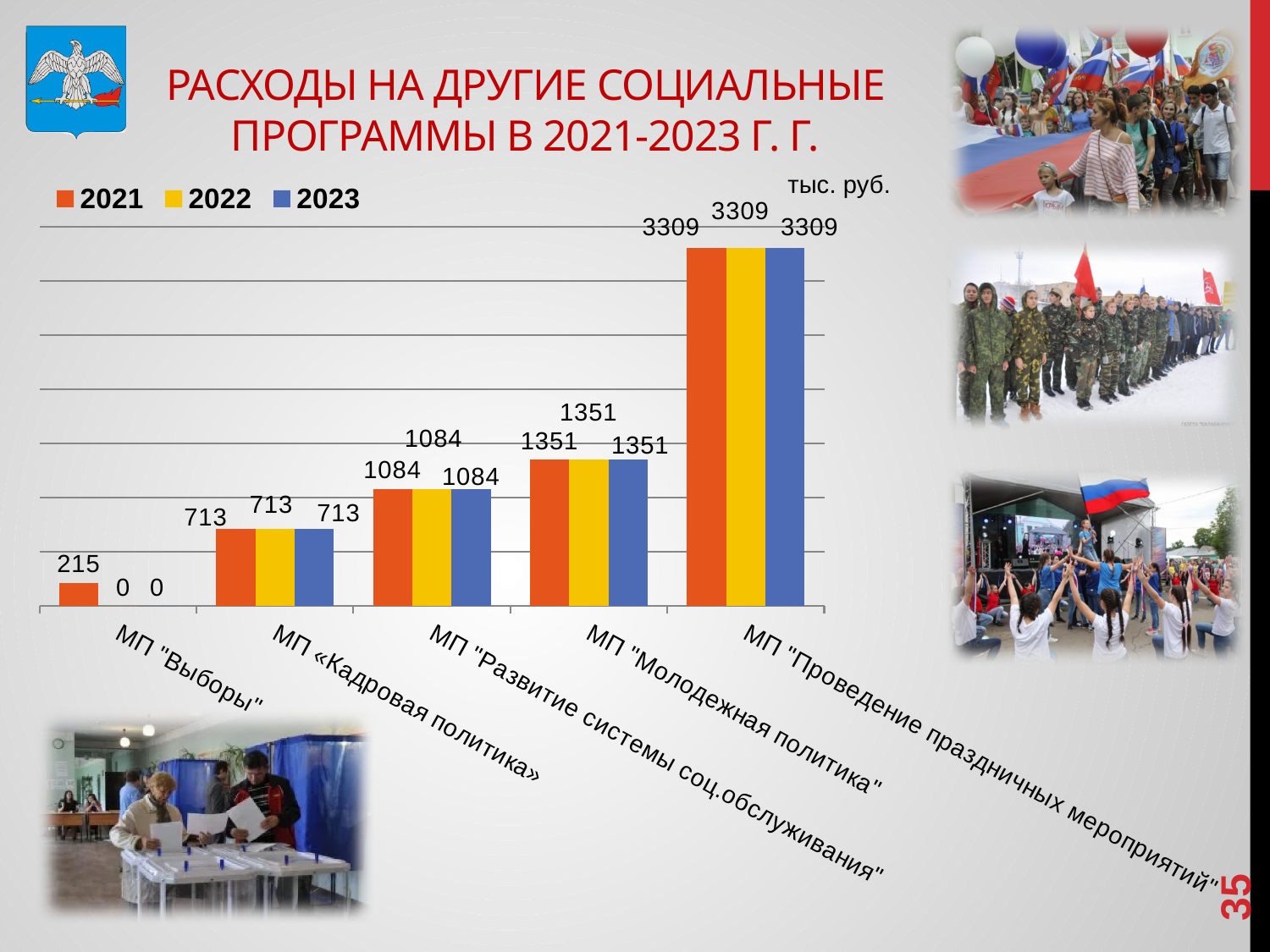
What is the 2022 value for МП "Проведение праздничных мероприятий"? 3309 What is the 2021 value for МП "Развитие системы соц.обслуживания"? 1084 What unit is indicated above the chart? тыс. руб. Which category has the highest 2023 value? МП "Проведение праздничных мероприятий" Which category has the lowest 2022 value? МП "Выборы" How many categories are shown on the x axis? 5 What kind of chart is shown on the slide? bar chart What is the difference between the 2021 values for МП "Молодежная политика" and МП «Кадровая политика»? 638 What is the 2021 value for МП "Выборы"? 215 What is the 2022 value for МП "Выборы"? 0 What is the 2023 value for МП «Кадровая политика»? 713 How many series does the legend list? 3